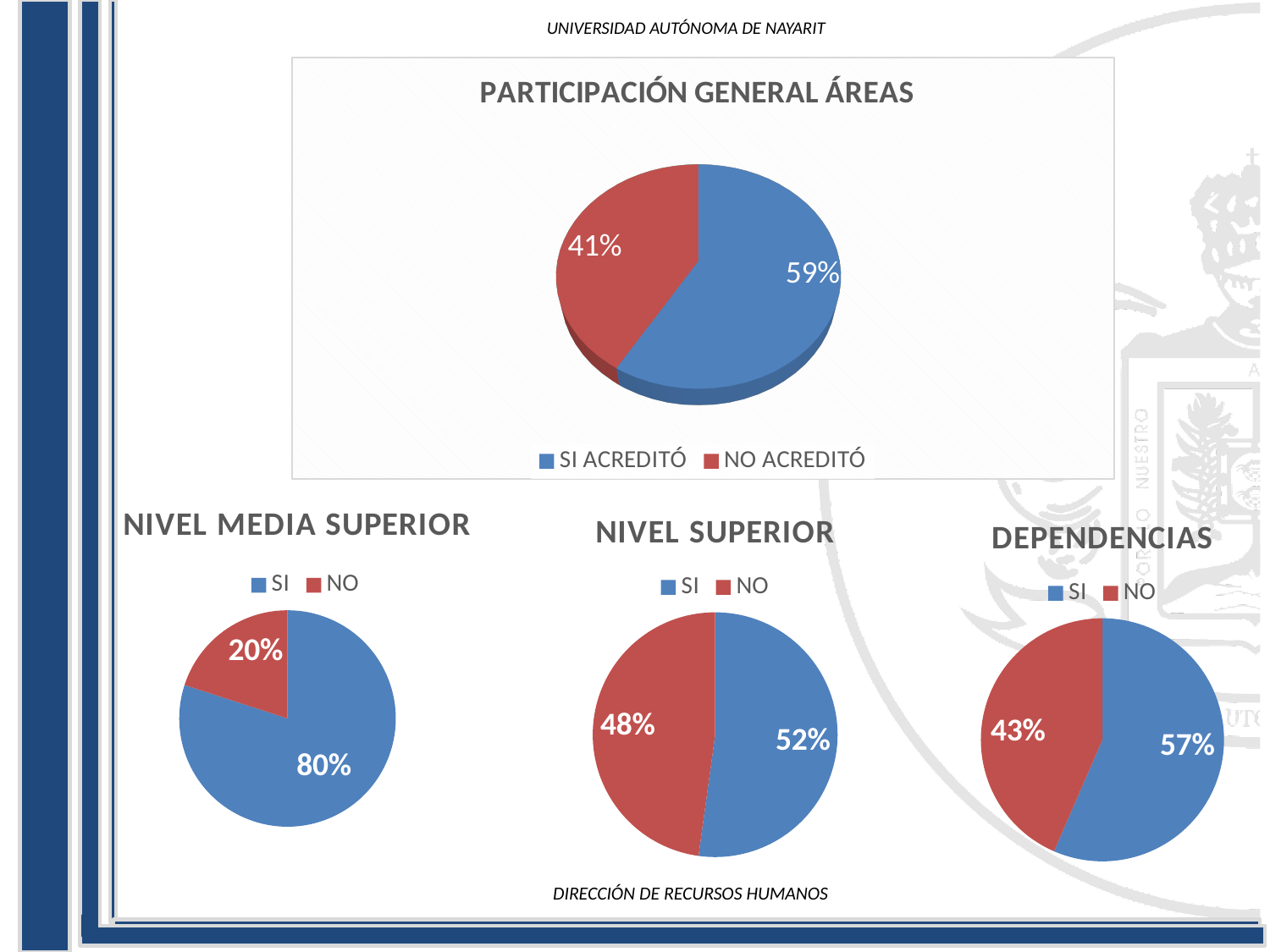
In the 'DEPENDENCIAS' chart, what is the difference between the SI and NO percentages? 14% In the 'PARTICIPACIÓN GENERAL ÁREAS' chart, what percentage is shown for SI ACREDITÓ? 59% In the 'NIVEL MEDIA SUPERIOR' chart, what is the difference between the SI and NO percentages? 60% How many pie charts are shown on the slide? 4 In the 'DEPENDENCIAS' chart, what percentage is shown for SI? 57% In the 'NIVEL SUPERIOR' chart, which slice is larger, SI or NO? SI What kind of chart is 'PARTICIPACIÓN GENERAL ÁREAS'? Pie chart In the 'NIVEL MEDIA SUPERIOR' chart, what percentage is shown for SI? 80% In the 'NIVEL SUPERIOR' chart, what percentage is shown for NO? 48% In the 'NIVEL MEDIA SUPERIOR' chart, what percentage is shown for NO? 20% In the 'PARTICIPACIÓN GENERAL ÁREAS' chart, what percentage is shown for NO ACREDITÓ? 41% How many entries does the legend of the 'PARTICIPACIÓN GENERAL ÁREAS' chart list? 2